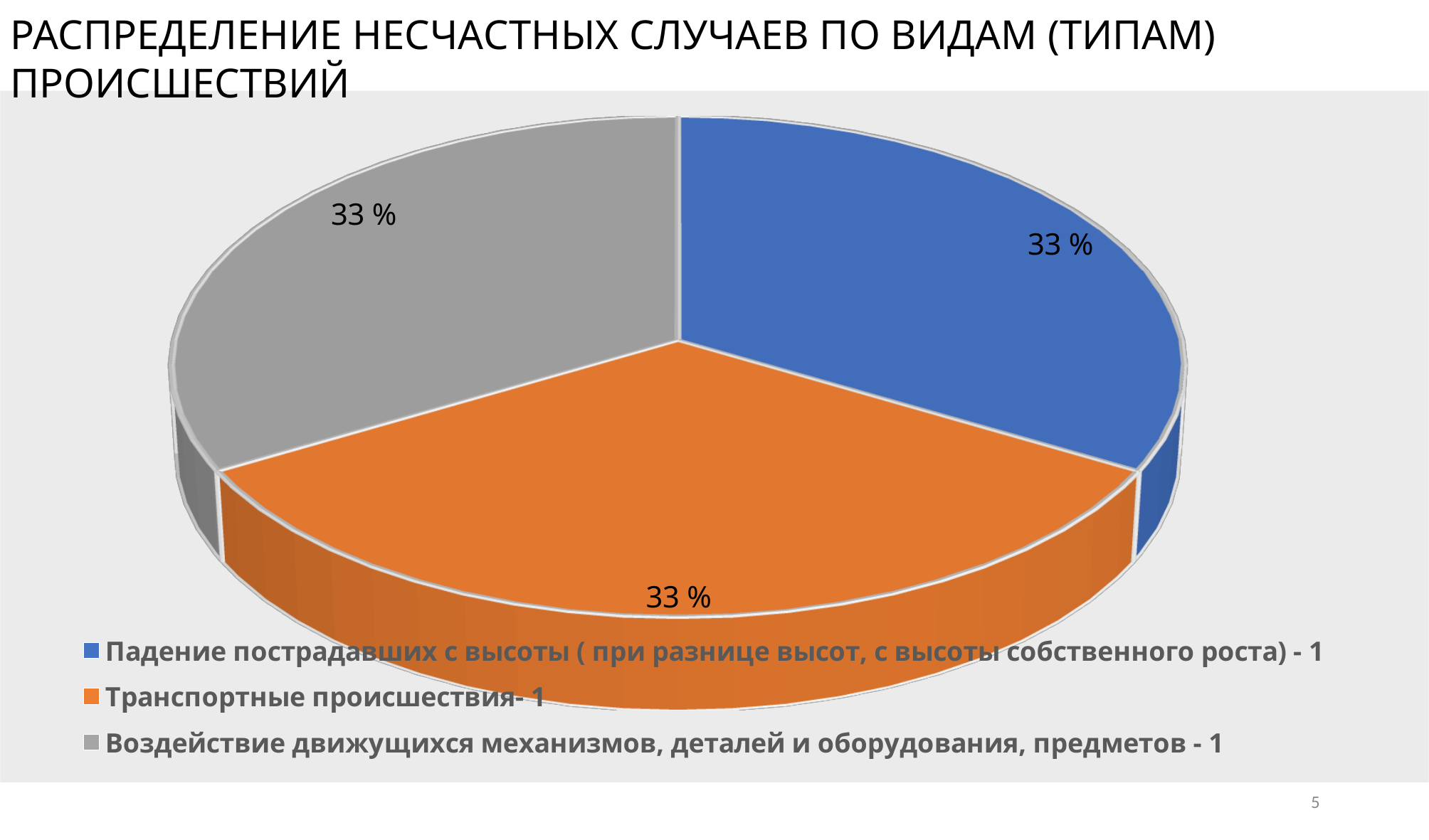
What is the total number of cases across all three categories listed in the legend? 3 According to the legend, how many cases are attributed to Воздействие движущихся механизмов, деталей и оборудования, предметов? 1 What share of the pie is labelled for the blue slice (Падение пострадавших с высоты)? 33 % What share of the pie is labelled for the orange slice (Транспортные происшествия)? 33 % What kind of chart is shown on the slide? Pie chart What is the title of the chart on the slide? РАСПРЕДЕЛЕНИЕ НЕСЧАСТНЫХ СЛУЧАЕВ ПО ВИДАМ (ТИПАМ) ПРОИСШЕСТВИЙ According to the legend, how many cases are attributed to Транспортные происшествия? 1 Which colour represents Транспортные происшествия in the legend? Orange How many slices does the pie chart have? 3 What is the difference in the number of cases between Транспортные происшествия and Падение пострадавших с высоты? 0 According to the legend, how many cases are attributed to Падение пострадавших с высоты? 1 What share of the pie is labelled for the grey slice (Воздействие движущихся механизмов, деталей и оборудования, предметов)? 33 %